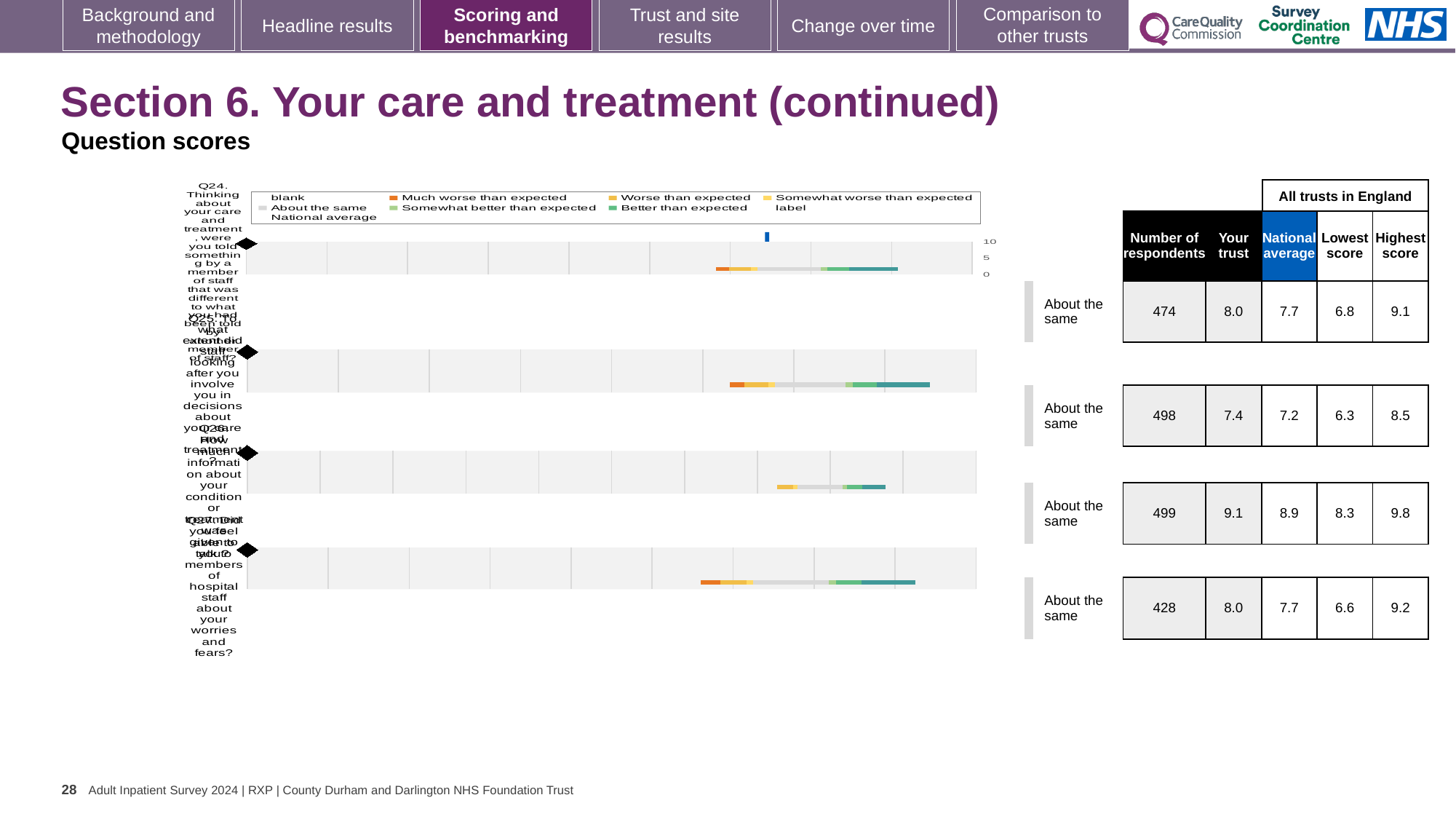
For Q27 (talking to staff about your worries and fears), which is larger: the 'Your trust' score or the national average? Your trust How many questions (rows) are plotted on this slide? 4 What is the highest score across all trusts in England for Q26? 9.8 What kind of chart is used to show the question scores on this slide? Bar chart How many respondents are shown for Q24 (being told something different by a member of staff)? 474 Which question has the lowest number of respondents on this slide? Q27 What is the lowest score across all trusts in England for Q25? 6.3 What benchmark category is shown for Q24 on this slide? About the same What is the difference between the 'Your trust' score and the national average for Q25? 0.2 Which question has the highest 'Your trust' score on this slide? Q26 What is the national average score for Q25 (staff involving you in decisions about your care and treatment)? 7.2 What is the 'Your trust' score for Q26 (information about your condition or treatment)? 9.1